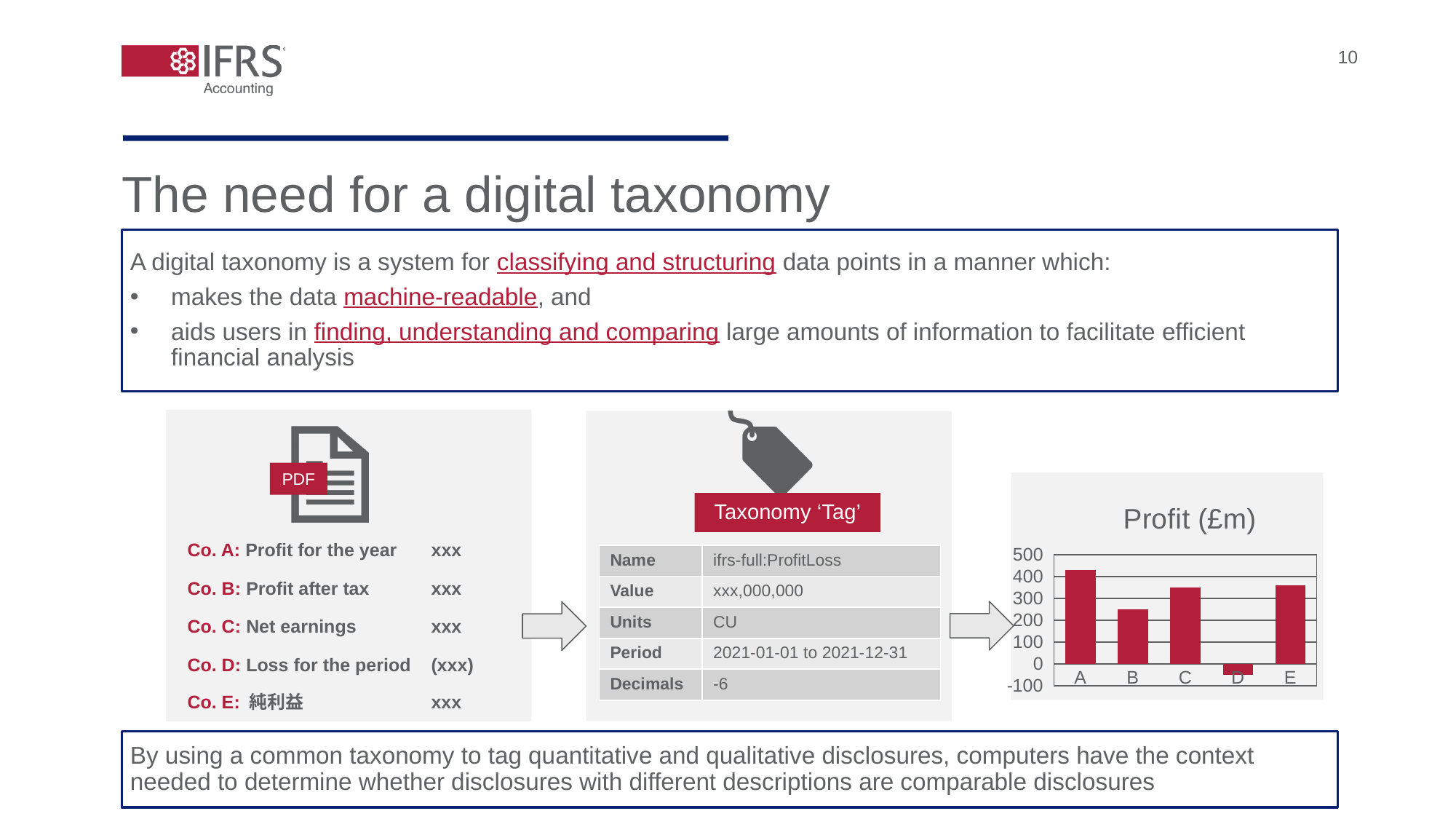
Which is larger, the value for A or the value for B? A Which category has the lowest value in the Profit (£m) chart? D Which is larger, the value for B or the value for C? C Is the value for A greater or less than 400? greater How many categories are plotted in the Profit (£m) chart? 5 Is the value for C greater or less than 300? greater What is the title of the chart? Profit (£m) Is the value for D greater or less than 0? less What is the lowest tick shown on the vertical axis of the Profit (£m) chart? -100 Which category has the highest value in the Profit (£m) chart? A What kind of chart is shown on the slide? bar chart